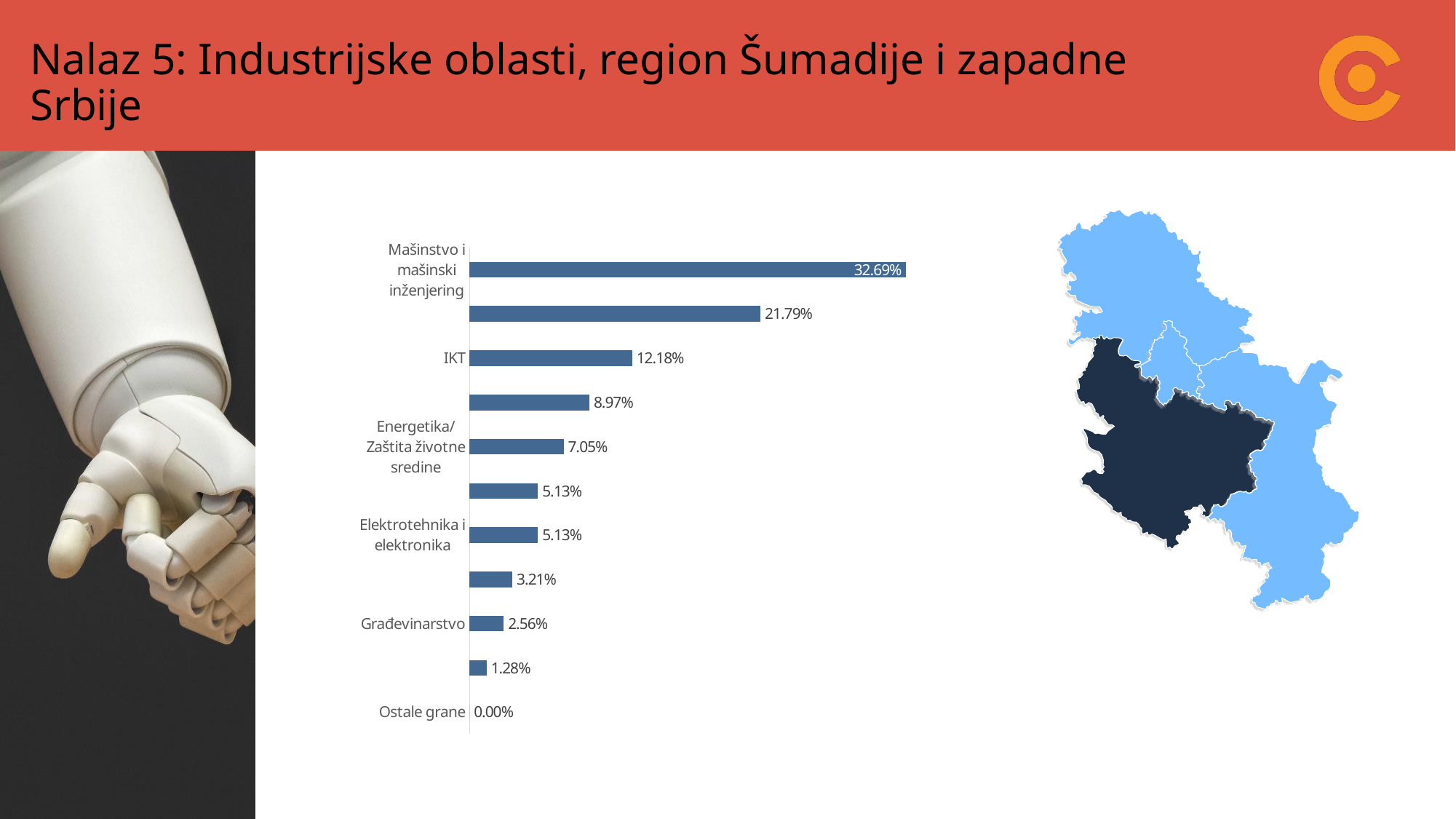
Which category has the lowest value? Ostale grane What kind of chart is shown on the slide? bar chart What is the value for IKT? 12.18% What is the value for Ostale grane? 0.00% What is the value for Građevinarstvo? 2.56% Do the bar values increase or decrease going from the top of the chart to the bottom? decrease What is the value for Elektrotehnika i elektronika? 5.13% Which is larger, the value for IKT or the value for Građevinarstvo? IKT What is the difference between the values for Mašinstvo i mašinski inženjering and IKT? 20.51% Which category has the highest value? Mašinstvo i mašinski inženjering What is the value for Mašinstvo i mašinski inženjering? 32.69% What is the value for Energetika/Zaštita životne sredine? 7.05%